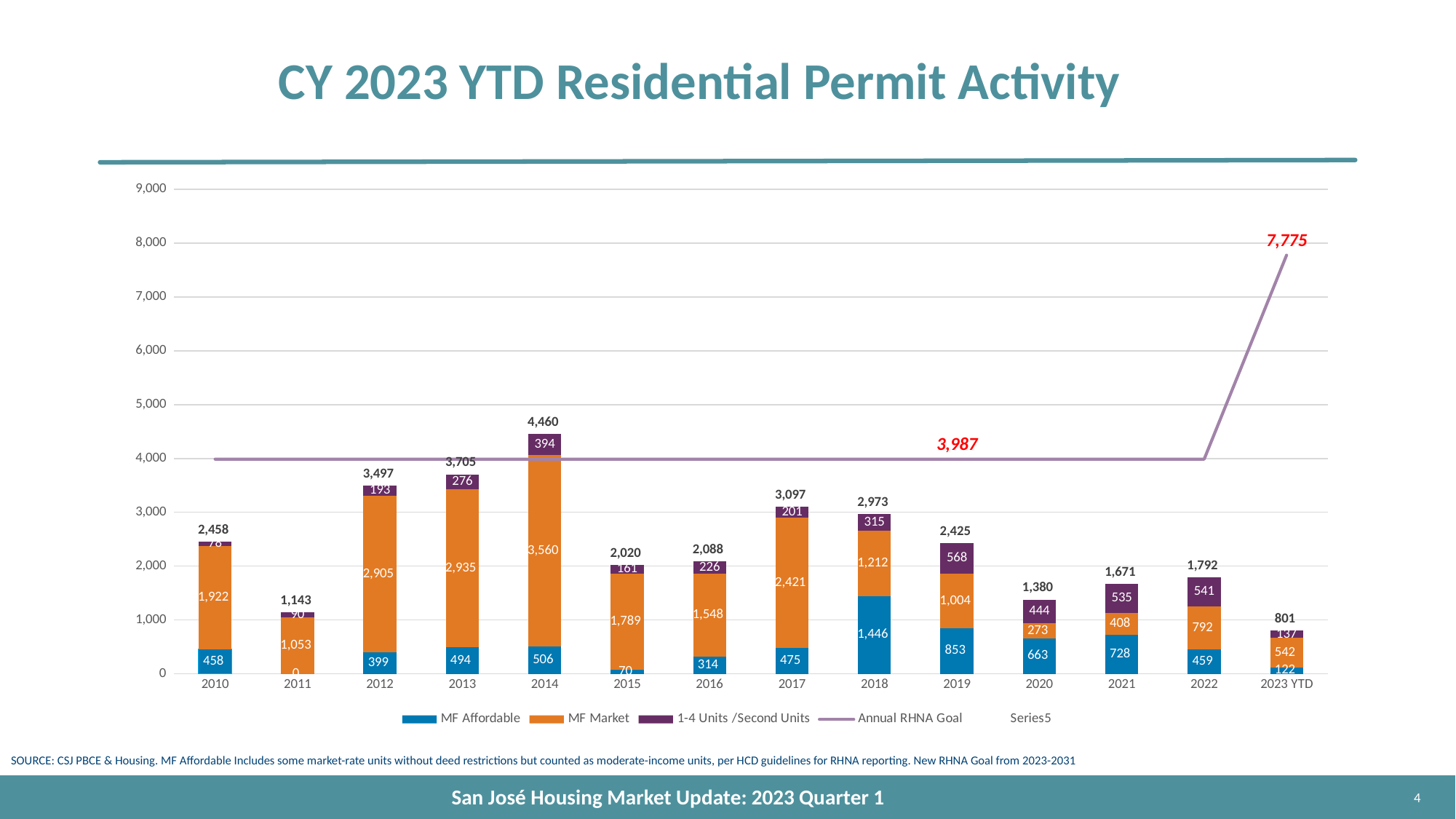
Which year has the highest total bar? 2014 What is the total number of residential permits shown for 2014? 4,460 Which is larger, the 1-4 Units/Second Units value for 2019 or for 2022? 2019 What value does the Annual RHNA Goal line reach at 2023 YTD? 7,775 What is the difference between the total for 2013 and the total for 2012? 208 What is the MF Market value for 2017? 2,421 Which category has the lowest total bar? 2023 YTD How many entries does the legend list? 5 How many years (categories) are shown on the x axis? 14 What is the MF Affordable value for 2018? 1,446 What kind of chart is this? Stacked bar chart with a line